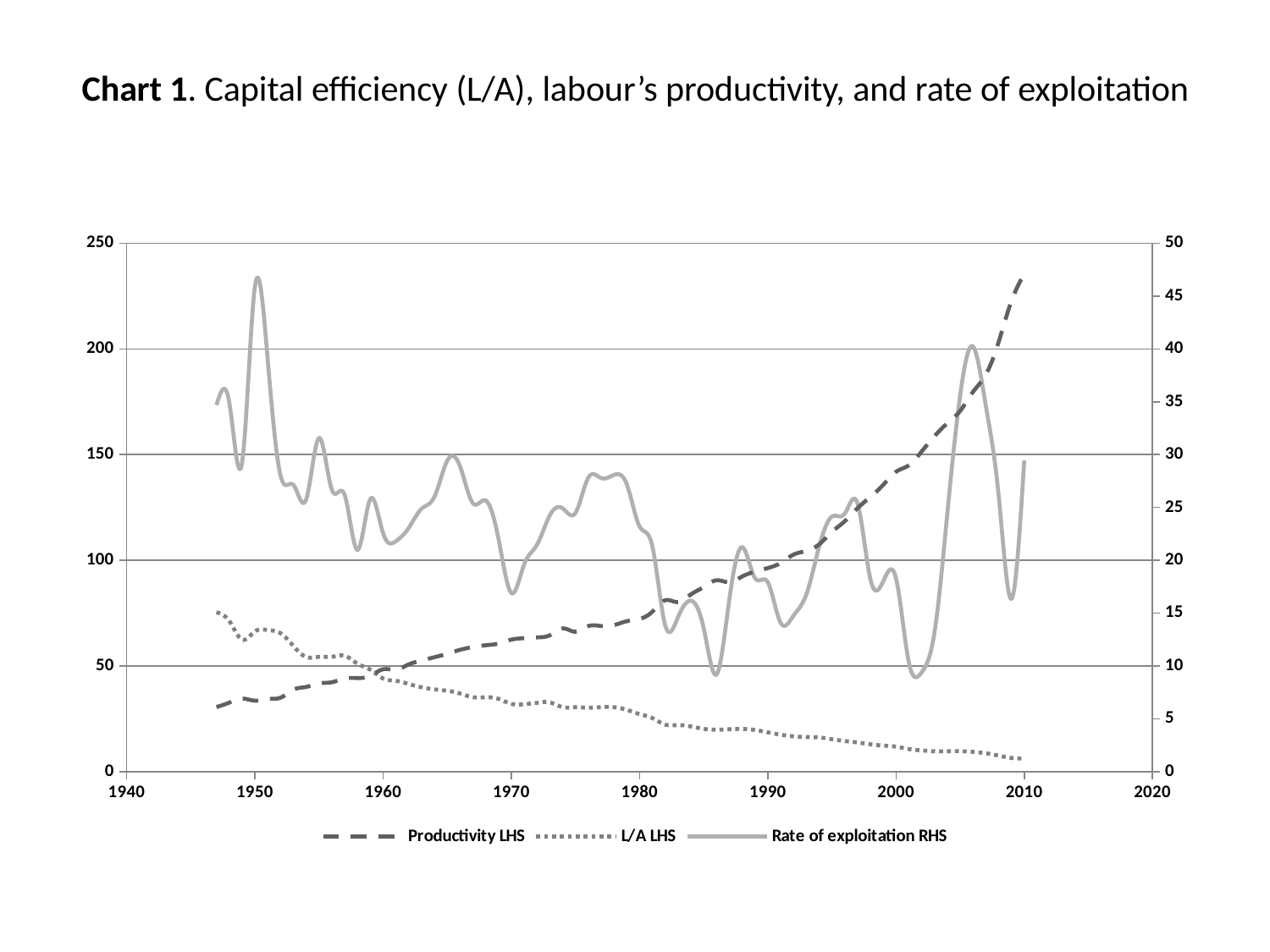
Is the value of Rate of exploitation RHS around 1950 greater or less than 40 on the right-hand axis? greater Is the value of Productivity LHS in 1947 greater or less than 50? less Is the value of Rate of exploitation RHS around 1970 greater or less than 20 on the right-hand axis? less What kind of chart is shown on the slide? Line chart How many series does the legend list? 3 Does the L/A LHS series rise or fall from 1947 to 2010? Fall In 1980, which is larger: Productivity LHS or L/A LHS? Productivity LHS Does the Productivity LHS series rise or fall from 1947 to 2010? Rise In 1950, which is larger: Productivity LHS or L/A LHS? L/A LHS Which series is plotted against the right-hand axis according to the legend? Rate of exploitation RHS